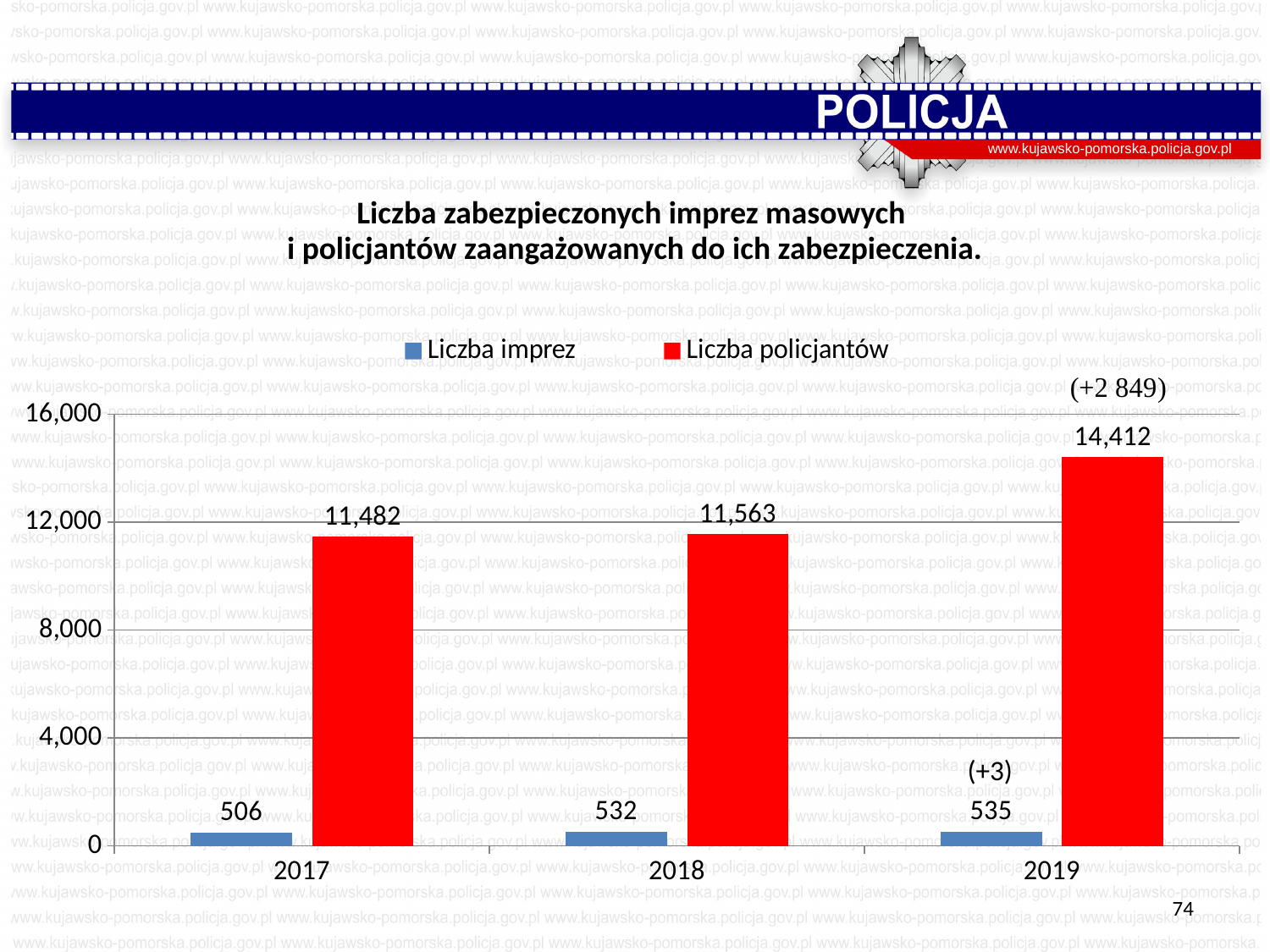
What is the value of Liczba policjantów for 2019? 14,412 What is the value of Liczba imprez for 2017? 506 How many series does the legend list? 2 Which year has the highest value for Liczba policjantów? 2019 What is the difference between Liczba policjantów in 2019 and 2018? 2,849 Which is larger: Liczba policjantów in 2017 or in 2019? 2019 What is the value of Liczba policjantów for 2018? 11,563 Which year has the lowest value for Liczba imprez? 2017 What kind of chart is shown on the slide? Bar chart What is the value of Liczba imprez for 2019? 535 How many years are shown on the x axis? 3 What is the difference between Liczba imprez in 2018 and 2017? 26